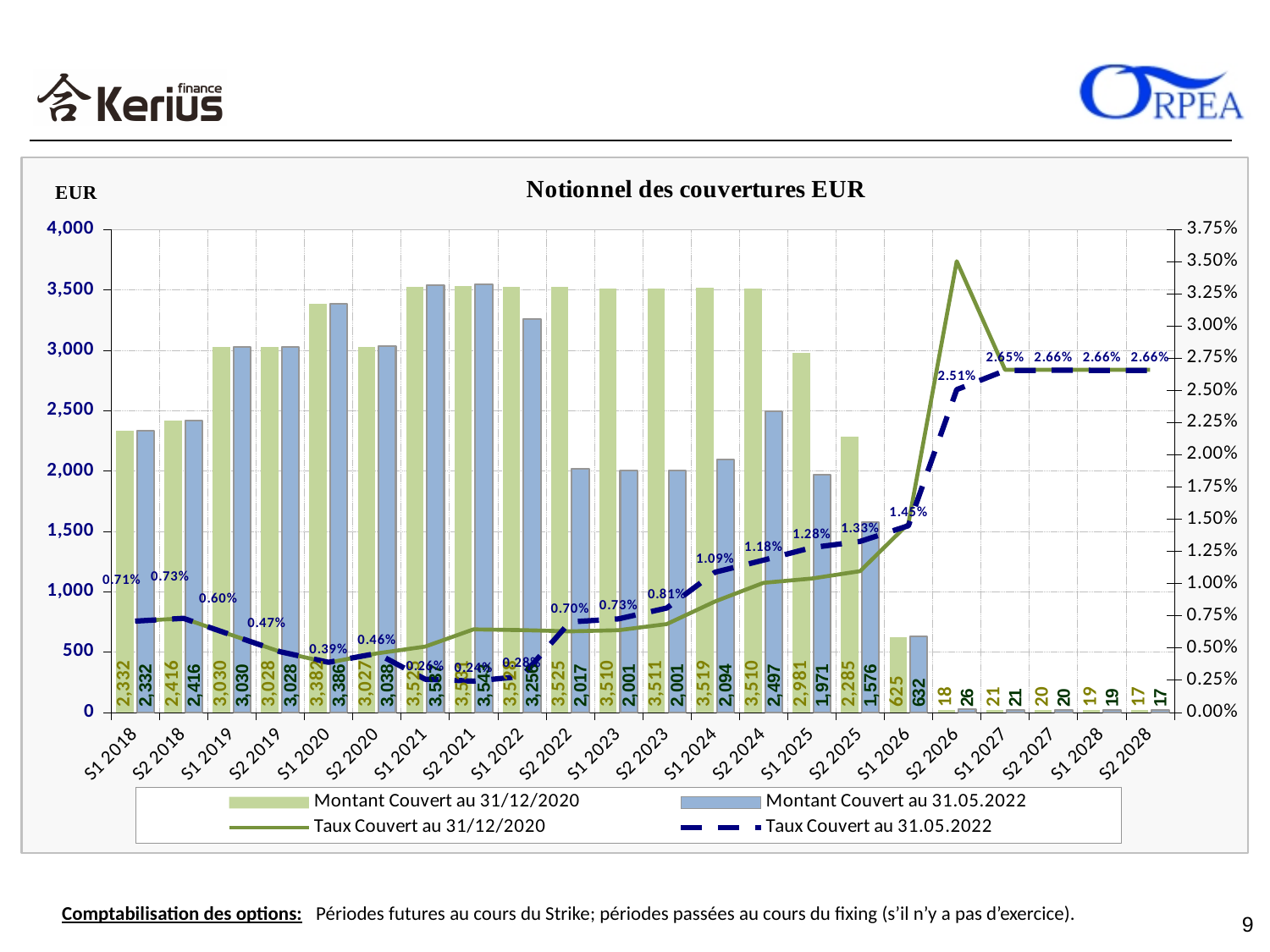
What kind of chart is shown on the slide? A combination bar and line chart What is the title of the chart? Notionnel des couvertures EUR Is the Taux Couvert au 31/12/2020 for S2 2026 greater or less than 3.25%? greater For S2 2024, which is larger: the Montant Couvert au 31/12/2020 or the Montant Couvert au 31.05.2022? Montant Couvert au 31/12/2020 What is the Taux Couvert au 31.05.2022 for S2 2026? 2.51% What is the Montant Couvert au 31/12/2020 for S1 2025? 2,981 In which period is the Taux Couvert au 31.05.2022 lowest? S2 2021 What is the Montant Couvert au 31.05.2022 for S1 2026? 632 What is the Montant Couvert au 31.05.2022 for S2 2022? 2,017 How many series does the legend list? 4 How many periods are shown along the x axis? 22 For S2 2022, what is the difference between the Montant Couvert au 31/12/2020 and the Montant Couvert au 31.05.2022? 1,508